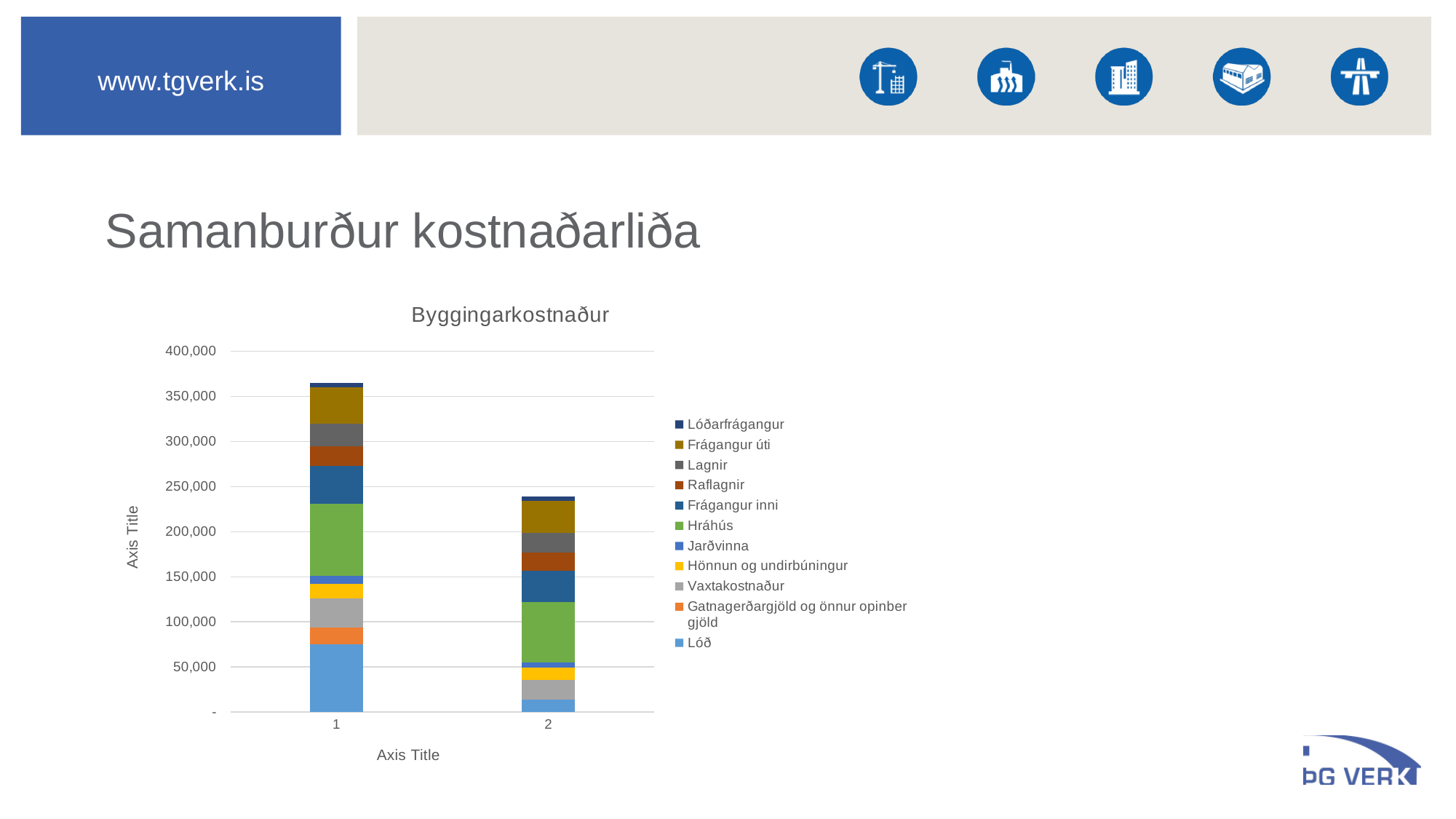
How many bars (categories) are plotted on the x axis? 2 What kind of chart is shown on the slide? Stacked bar chart Which category has the lowest total building cost? 2 Is the total of the stacked bar for category 1 greater or less than 350,000? greater How many series does the legend list? 11 What is the title of the chart? Byggingarkostnaður Is the Lóð segment for category 1 greater or less than 50,000? greater Is the Lóð segment for category 2 greater or less than 50,000? less Do the stacked bar totals rise or fall from category 1 to category 2? fall Which series is listed first in the legend? Lóðarfrágangur Which category has the taller stacked bar, 1 or 2? 1